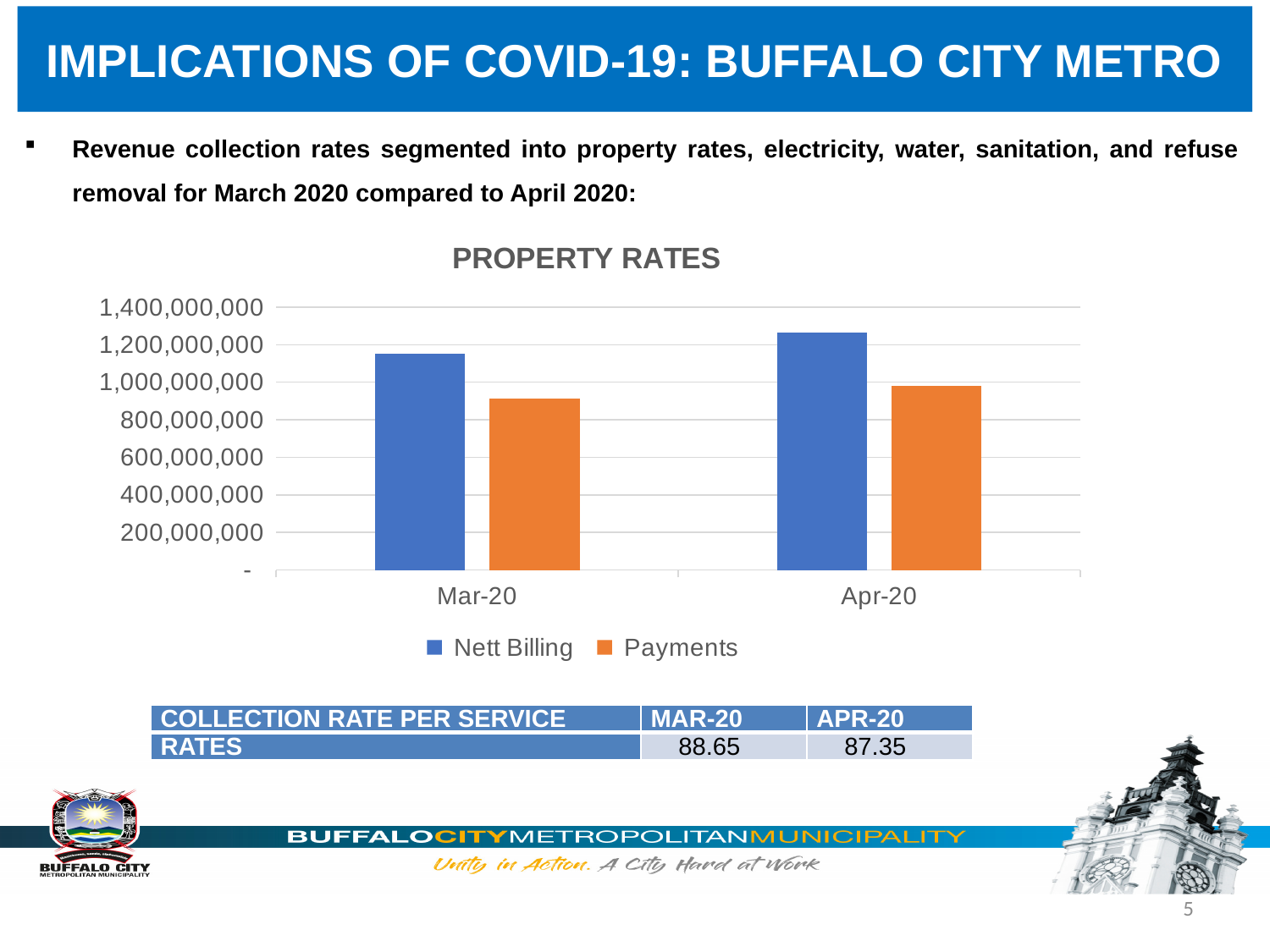
Is the Nett Billing value for Apr-20 greater or less than 1,200,000,000? greater Which is larger in Apr-20, Nett Billing or Payments? Nett Billing Which series is shown in orange in the PROPERTY RATES chart? Payments How many series does the legend of the PROPERTY RATES chart list? 2 Which bar in the PROPERTY RATES chart is the lowest? Payments for Mar-20 Is the Payments value for Mar-20 greater or less than 1,000,000,000? less Is the Payments value for Apr-20 greater or less than 800,000,000? greater Which month has the higher Nett Billing value? Apr-20 Do the Payments values rise or fall from Mar-20 to Apr-20? rise How many categories are shown on the x axis of the PROPERTY RATES chart? 2 What type of chart is shown under the title PROPERTY RATES? bar chart